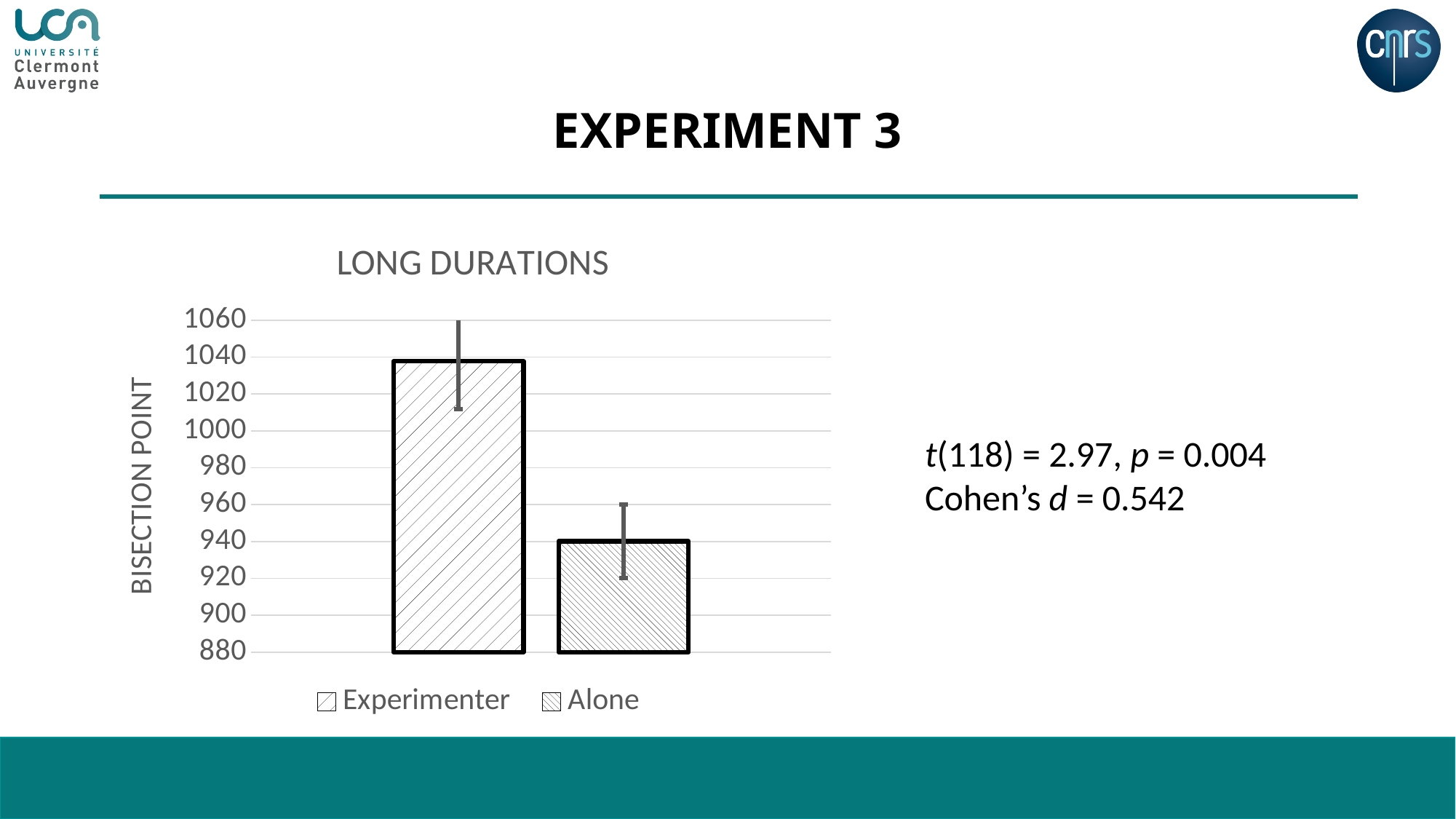
Which series has the lowest bisection point? Alone Is the value for Alone greater or less than 960? less What kind of chart is shown on the slide? bar chart Which series has the highest bisection point? Experimenter Is the value for Experimenter greater or less than 1000? greater What is the title of the chart? LONG DURATIONS How many bars are plotted in the chart? 2 Which is larger, the bisection point for Experimenter or for Alone? Experimenter How many series does the chart legend list? 2 Is the value for Alone greater or less than 920? greater What is the label of the vertical axis of the chart? BISECTION POINT